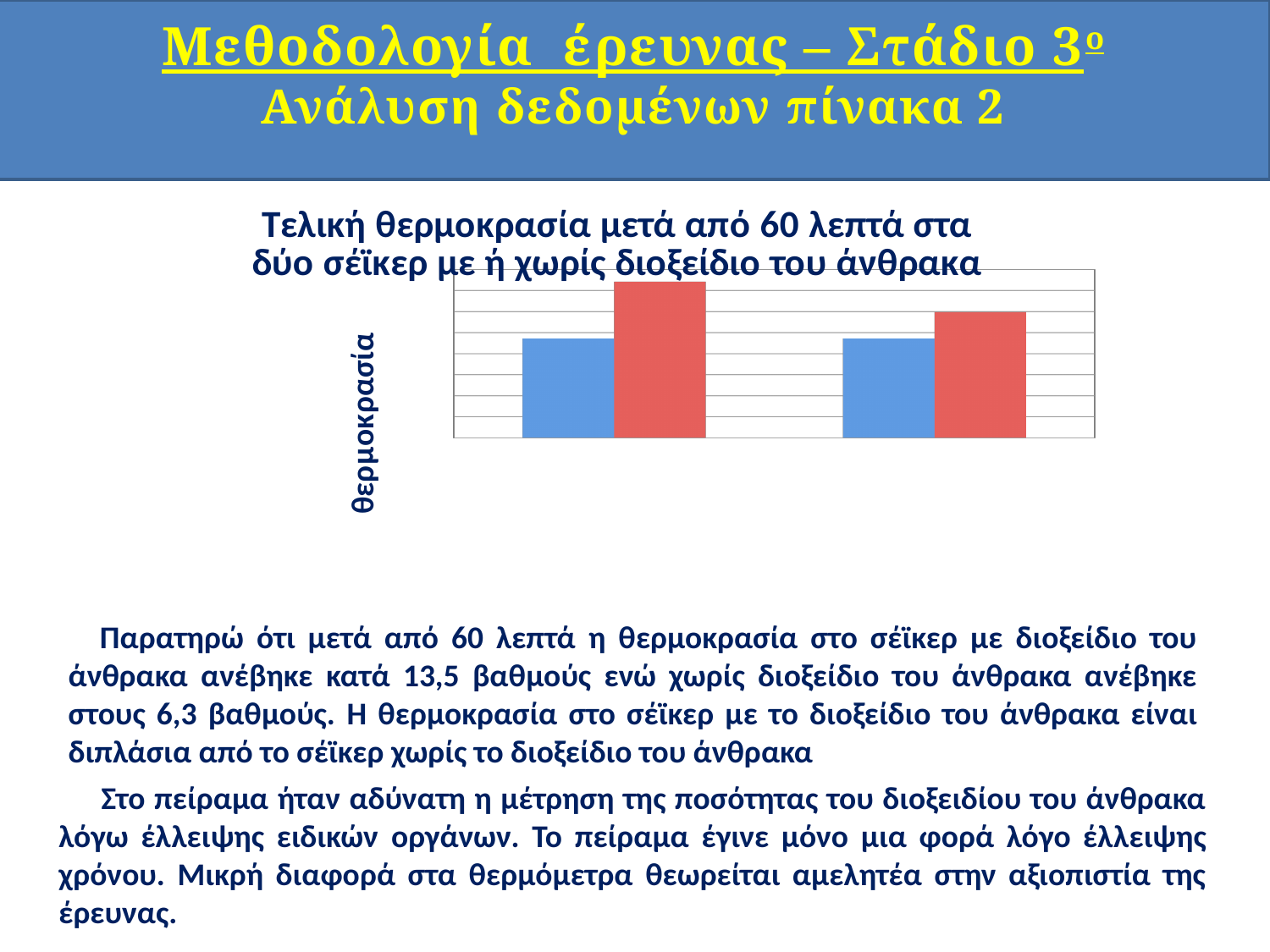
What is the title of the chart? Τελική θερμοκρασία μετά από 60 λεπτά στα δύο σέϊκερ με ή χωρίς διοξείδιο του άνθρακα How many bars are plotted in the chart? 4 How many groups of bars does the chart show? 2 In the right group of bars, which bar is taller, the blue one or the red one? the red one Which bar is the tallest in the chart? the red bar in the left group In the left group of bars, which bar is taller, the blue one or the red one? the red one What is the label on the vertical axis of the chart? θερμοκρασία What kind of chart is shown on the slide? bar chart Which red bar is taller, the one in the left group or the one in the right group? the one in the left group